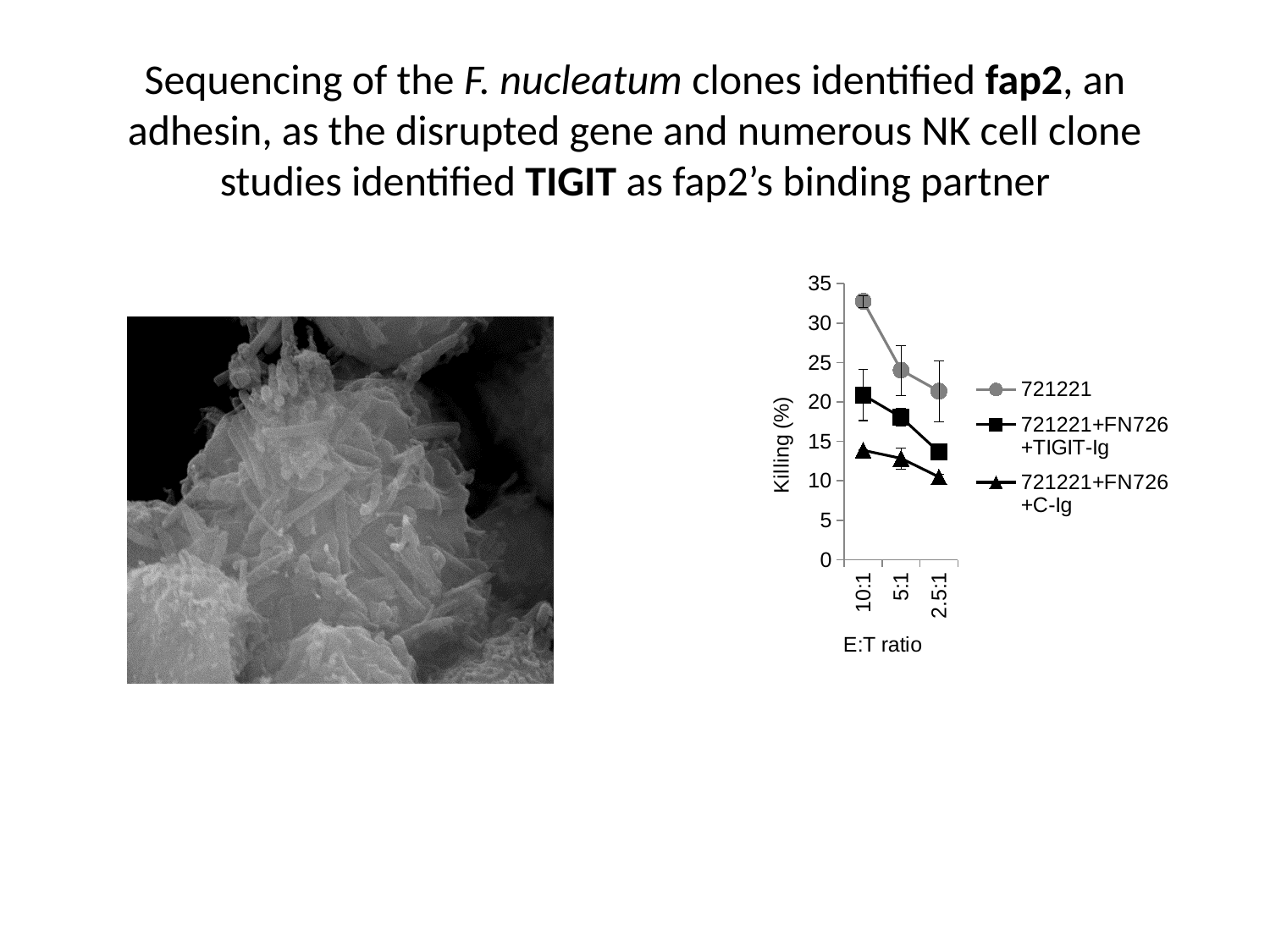
Is the killing percentage for 721221 at the 10:1 ratio greater or less than 30? greater Is the killing percentage for 721221+FN726+TIGIT-Ig at the 2.5:1 ratio greater or less than 15? less Is the killing percentage for 721221+FN726+C-Ig at the 5:1 ratio greater or less than 15? less What is the label of the y axis of the chart? Killing (%) At the 10:1 E:T ratio, which has the higher killing percentage: 721221 or 721221+FN726+C-Ig? 721221 What is the label of the x axis of the chart? E:T ratio Does the killing percentage for 721221 rise or fall as the E:T ratio goes from 10:1 to 2.5:1? fall Which series has the lowest killing percentage at the 10:1 E:T ratio? 721221+FN726+C-Ig What kind of chart is shown on the slide? line chart How many E:T ratio points are plotted along the x axis? 3 Which series has the highest killing percentage at the 10:1 E:T ratio? 721221 How many series does the chart legend list? 3